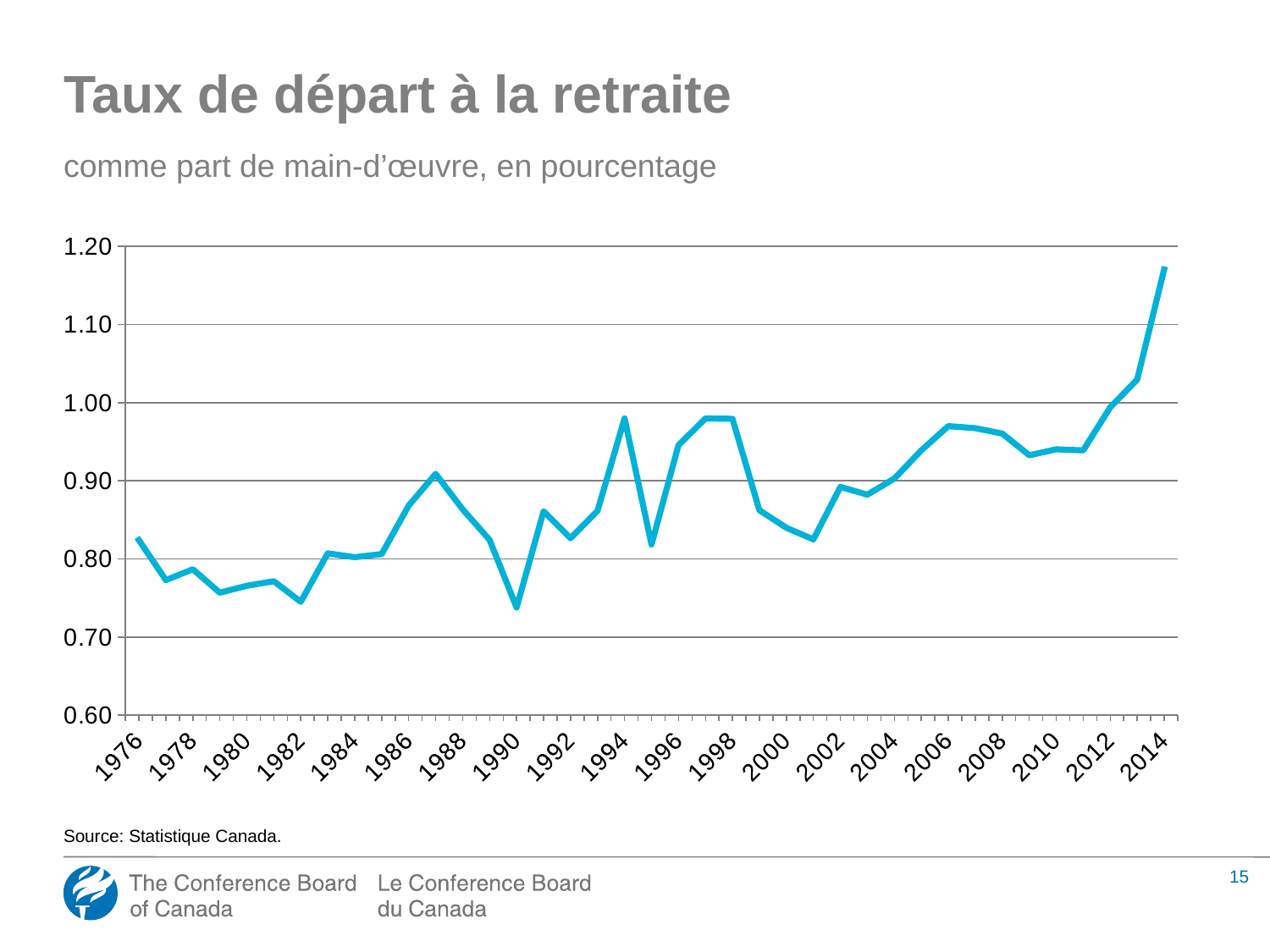
How many year labels are shown on the x axis? 20 Is the value for 2000 greater or less than 0.90? less What is the source cited below the chart? Statistique Canada Is the value for 1994 greater or less than 0.90? greater What kind of chart is shown on the slide? line chart Is the value for 2014 greater or less than 1.10? greater Which year has the highest value on the chart? 2014 Which is larger, the value for 1990 or the value for 1994? 1994 Overall, does the retirement rate rise or fall from 1976 to 2014? rise What is the title of the chart on the slide? Taux de départ à la retraite